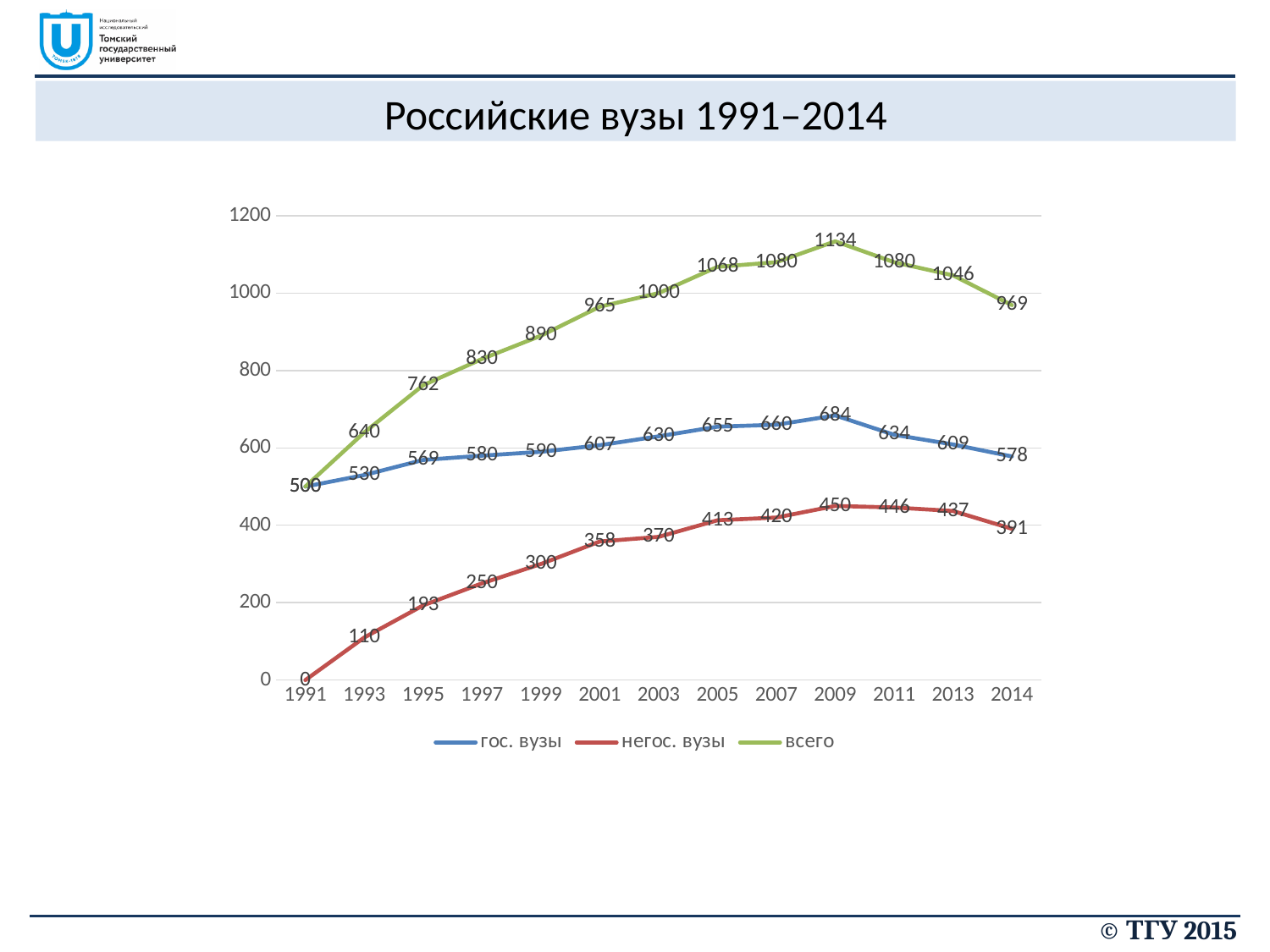
What is the difference between всего in 2009 and всего in 2014? 165 In which year does гос. вузы reach its highest value? 2009 Which is larger in 2013: гос. вузы or негос. вузы? гос. вузы In which year is негос. вузы at its lowest value? 1991 What is the value of негос. вузы in 2014? 391 What is the value of всего in 2009? 1134 What is the value of гос. вузы in 2001? 607 What is the title of the chart? Российские вузы 1991–2014 Does всего rise or fall between 1991 and 2009? rise How many series does the legend list? 3 What type of chart is shown on the slide? line chart How many years are plotted along the x axis? 13